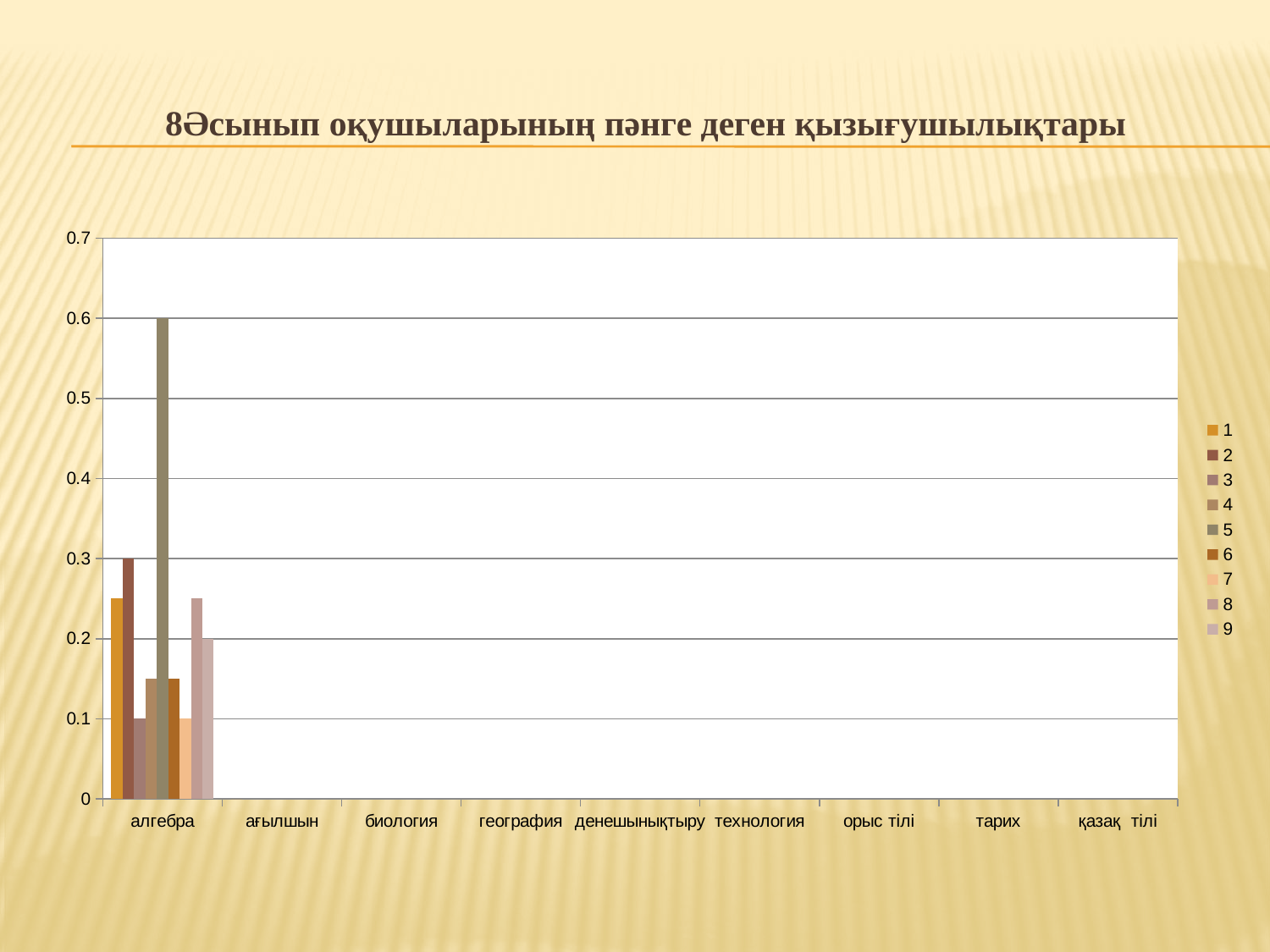
Which is larger for алгебра: series 5 or series 2? series 5 Is the value of series 1 for алгебра greater or less than 0.2? greater How many series does the legend list? 9 What is the value of series 2 for алгебра? 0.3 What is the difference between series 5 and series 2 for алгебра? 0.3 Which category is the only one with bars plotted? алгебра Which series has the highest value for алгебра? 5 What kind of chart is shown on the slide? bar chart What is the value of series 5 for алгебра? 0.6 What is the value of series 3 for алгебра? 0.1 How many categories are shown on the x axis? 9 What is the value of series 9 for алгебра? 0.2